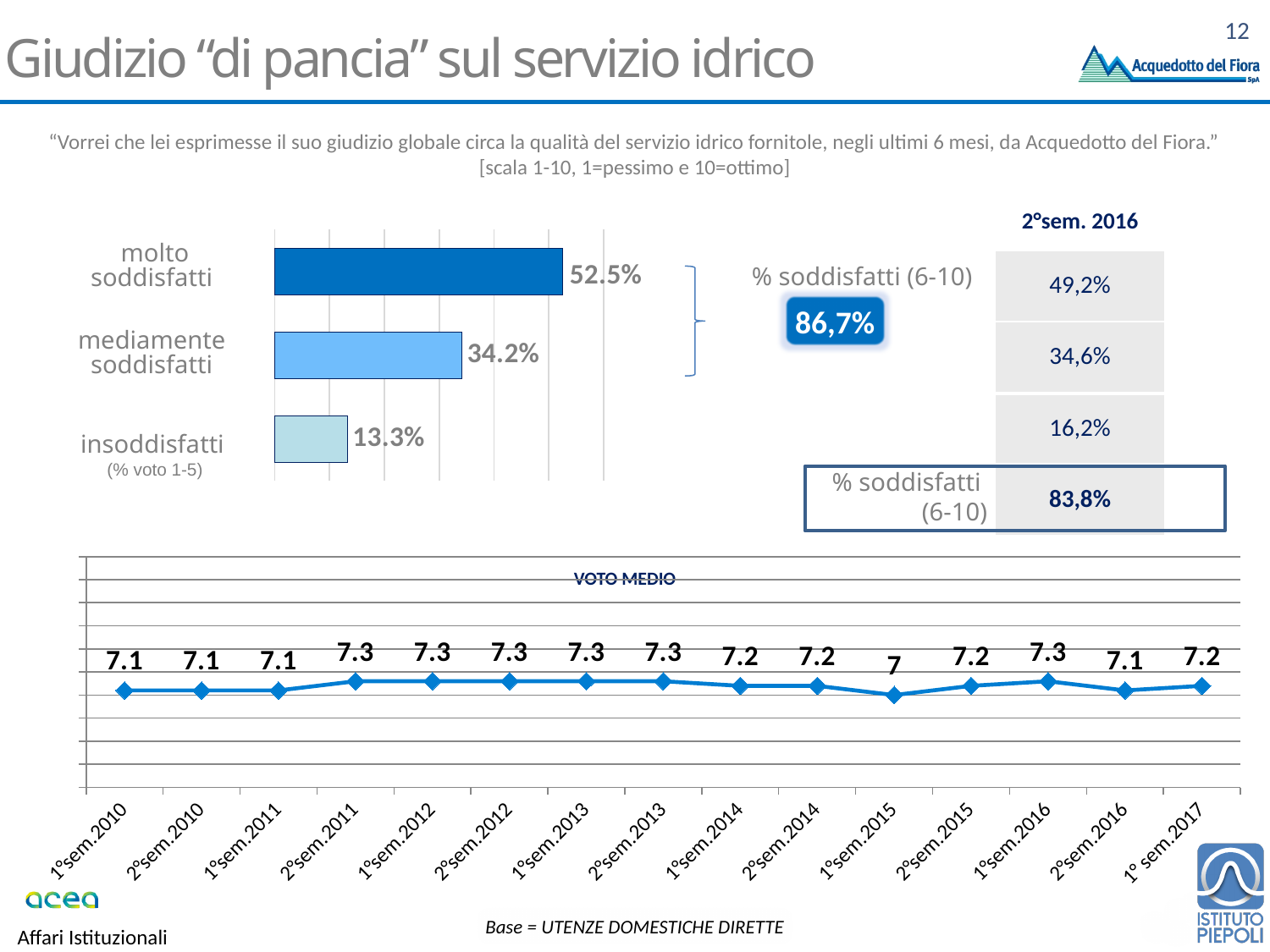
In the top bar chart, which category has the highest value? molto soddisfatti In the VOTO MEDIO line chart, how many data points are plotted? 15 In the top bar chart, what is the difference between "molto soddisfatti" and "mediamente soddisfatti"? 18.3% In the top bar chart, how many categories are shown? 3 In the top bar chart, which category has the lowest value? insoddisfatti In the VOTO MEDIO line chart, is the value for 2°sem.2011 larger or smaller than the value for 1°sem.2011? larger In the top bar chart, what is the value for "insoddisfatti"? 13.3% In the VOTO MEDIO line chart, what is the value for 1° sem.2017? 7.2 In the VOTO MEDIO line chart, which period has the lowest value? 1°sem.2015 In the VOTO MEDIO line chart, what is the value for 1°sem.2015? 7 What kind of chart is the top chart on the slide? bar chart In the top bar chart, what is the value for "molto soddisfatti"? 52.5%